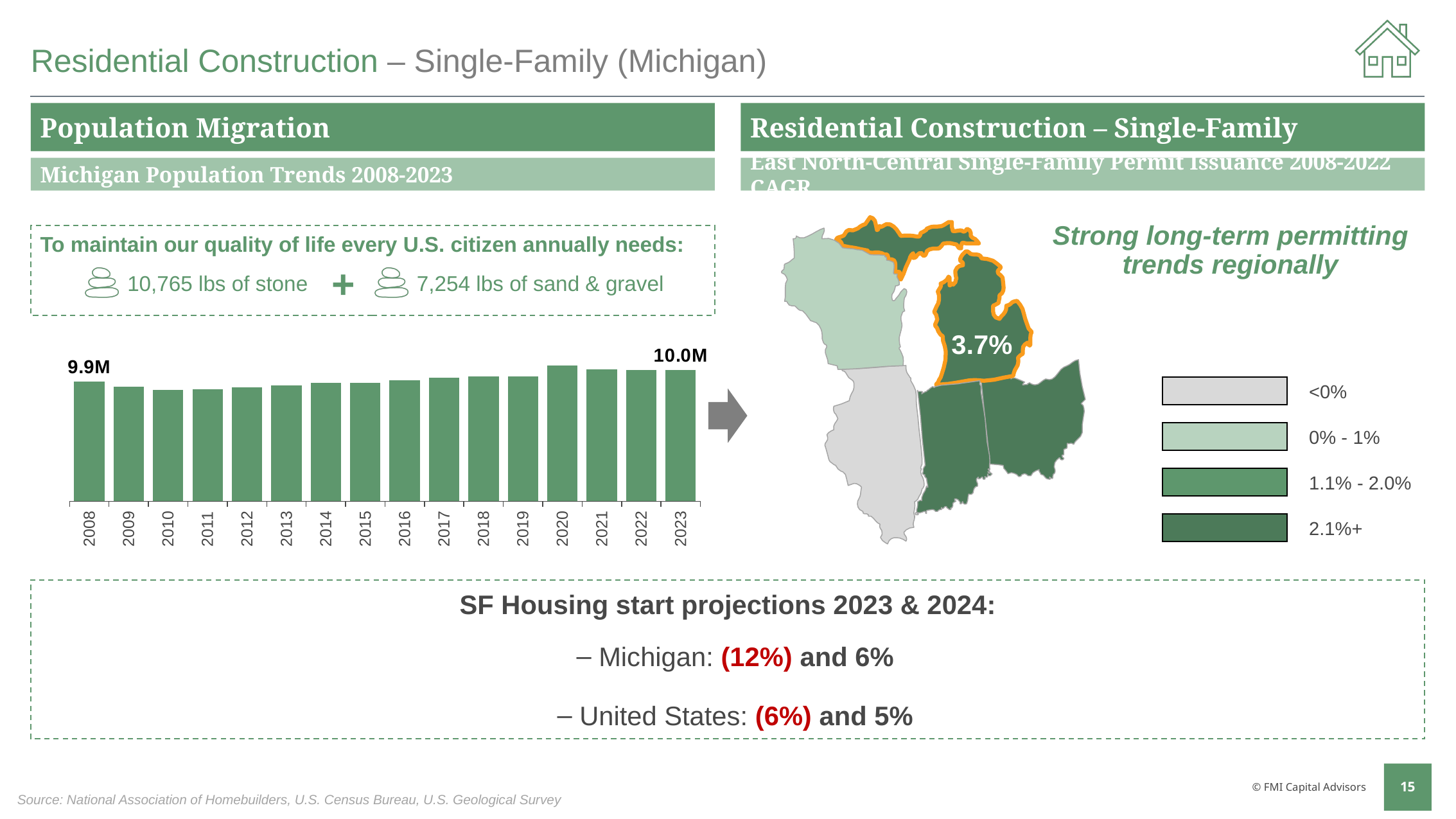
On the Michigan Population Trends chart, how many years are plotted? 16 On the Michigan Population Trends chart, what is the population value shown for 2008? 9.9M On the East North-Central Single-Family Permit Issuance map, which legend category does Michigan's 3.7% CAGR fall into? 2.1%+ On the Michigan Population Trends chart, which year has the larger value, 2008 or 2010? 2008 On the East North-Central Single-Family Permit Issuance map, how many categories does the legend list? 4 On the Michigan Population Trends chart, what is the first year shown on the x axis? 2008 What kind of chart is the Michigan Population Trends chart? bar chart On the East North-Central Single-Family Permit Issuance map, what CAGR value is printed on Michigan? 3.7% On the Michigan Population Trends chart, what is the difference between the 2023 value and the 2008 value? 0.1M On the Michigan Population Trends chart, does the population generally rise or fall from 2008 to 2023? rise On the Michigan Population Trends chart, what is the population value shown for 2023? 10.0M On the Michigan Population Trends chart, which year has the larger value, 2012 or 2020? 2020